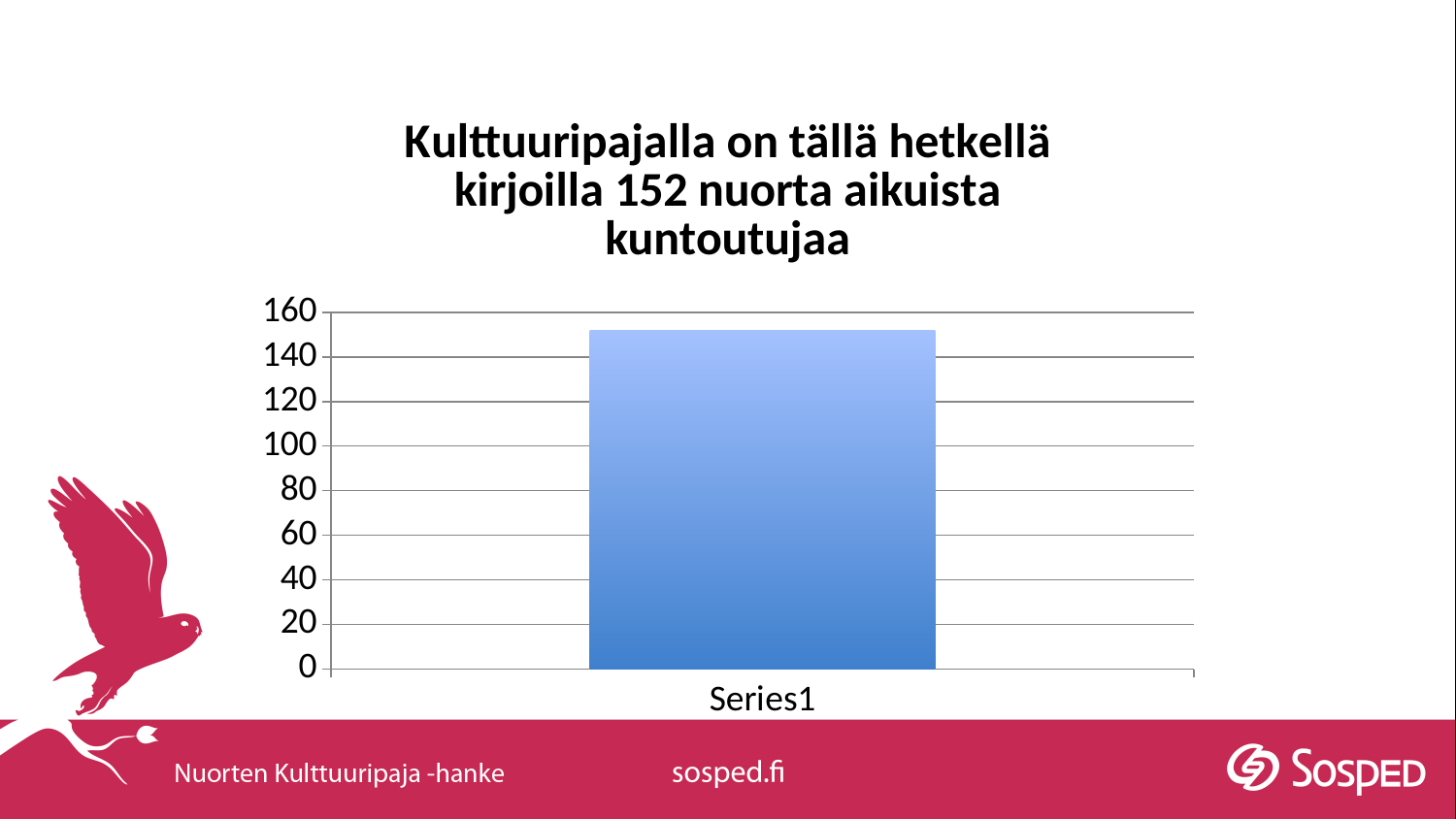
What is the highest value shown on the y axis? 160 According to the chart title, how many young adult rehabilitees are currently registered at Kulttuuripaja? 152 How many bars does the chart show? 1 What is the label of the category on the x axis? Series1 What kind of chart is shown on the slide? bar chart Is the value for Series1 greater or less than 140? greater Is the value for Series1 greater or less than 100? greater Is the value for Series1 greater or less than 160? less